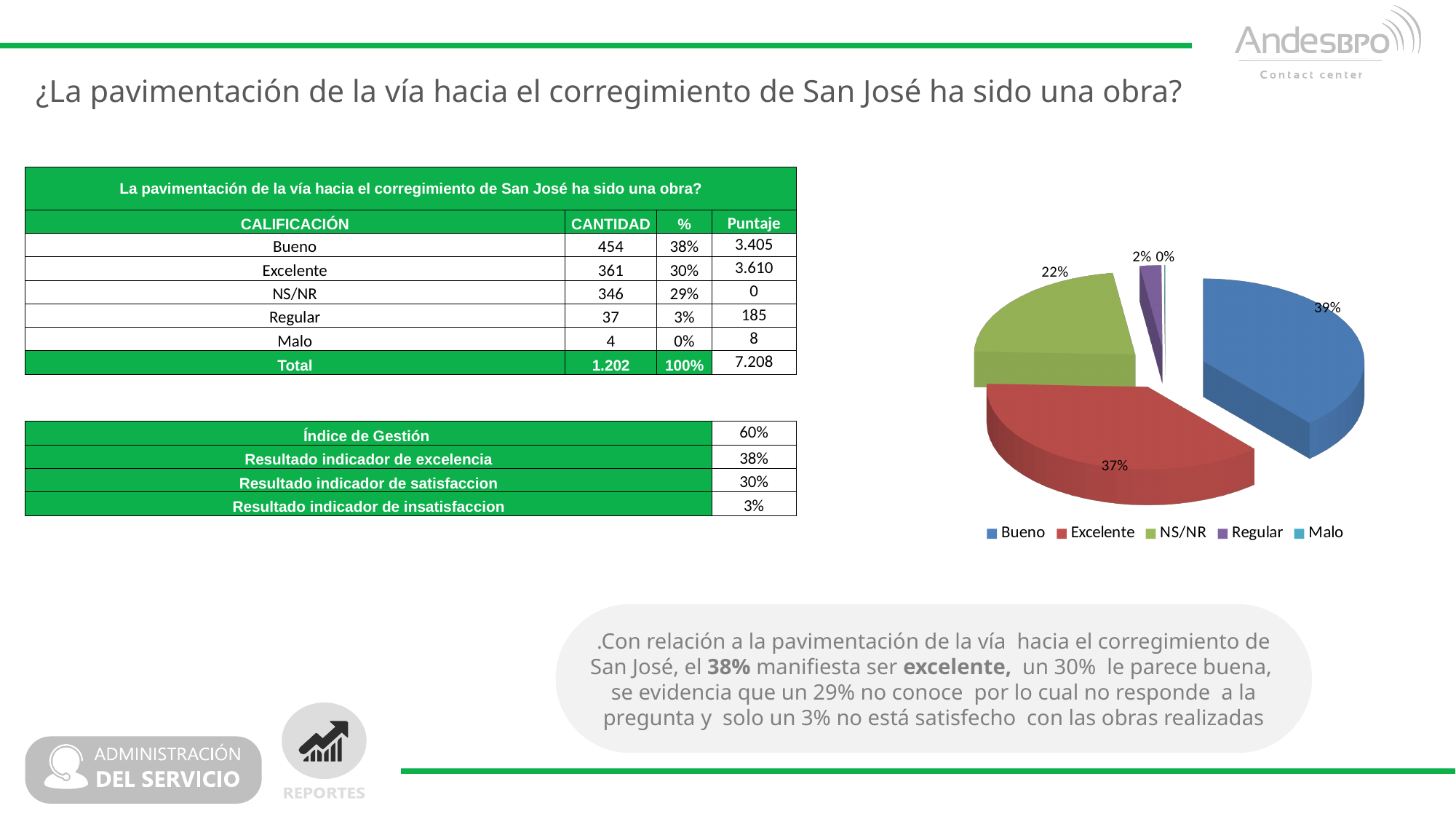
What percentage does the pie chart show for Regular? 2% What kind of chart is shown on the slide? pie chart In the pie chart, what is the difference in percentage points between Bueno and NS/NR? 17 What colour is the Excelente slice in the pie chart? red Which category has the largest slice in the pie chart? Bueno What percentage does the pie chart show for Malo? 0% What percentage does the pie chart show for Excelente? 37% How many series does the pie chart legend list? 5 Which category has the smallest slice in the pie chart? Malo What percentage does the pie chart show for NS/NR? 22% What percentage does the pie chart show for Bueno? 39% In the pie chart, which slice is larger: NS/NR or Regular? NS/NR